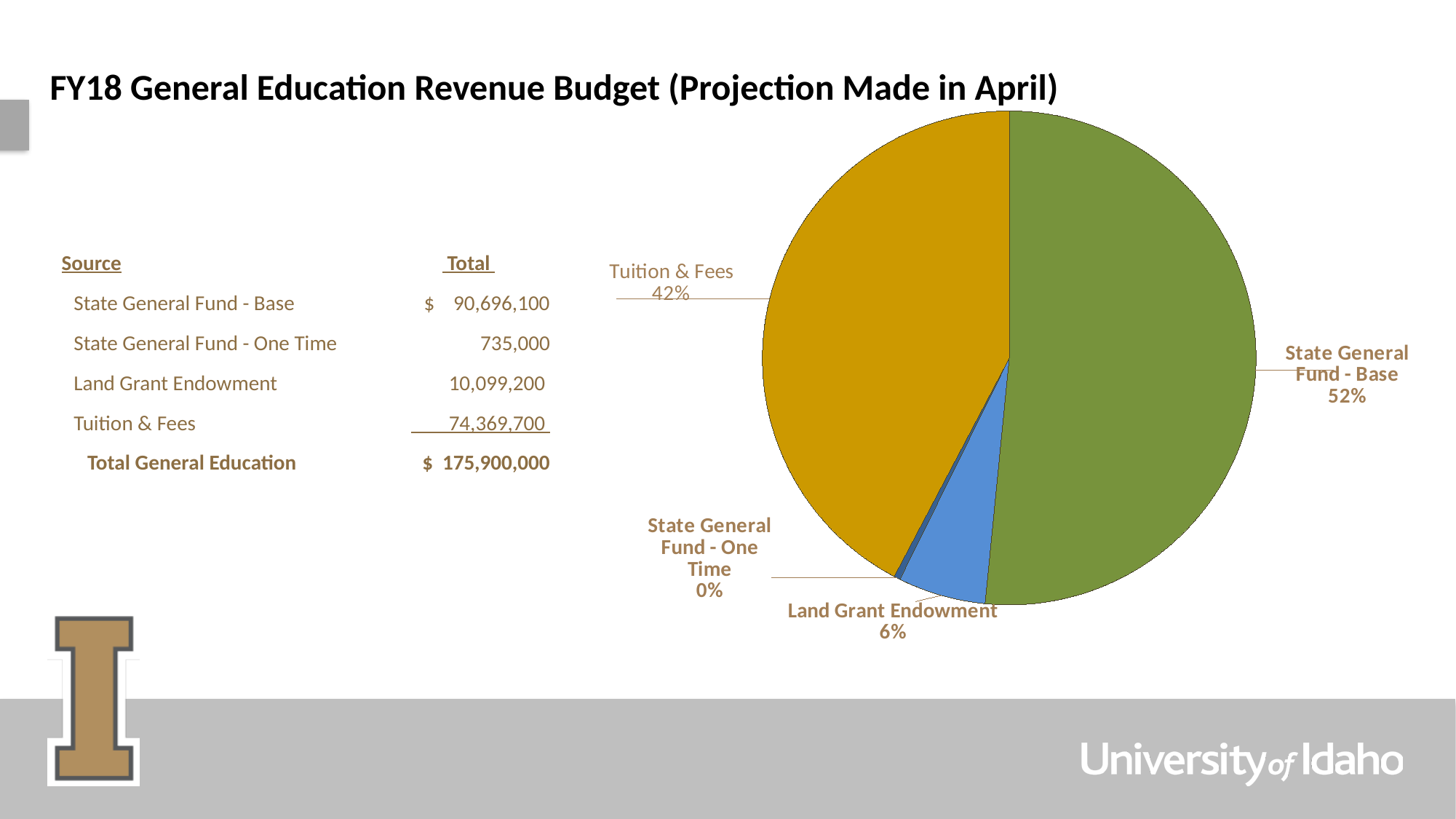
What is the difference in percentage points between the State General Fund - Base slice and the Tuition & Fees slice? 10 percentage points What colour is the Land Grant Endowment slice of the pie chart? blue Which is larger in the pie chart, Tuition & Fees or Land Grant Endowment? Tuition & Fees What share of the pie does State General Fund - Base represent? 52% What percentage is labelled for State General Fund - One Time on the pie chart? 0% What share of the pie does Tuition & Fees represent? 42% Which slice of the pie chart is the smallest? State General Fund - One Time What share of the pie does Land Grant Endowment represent? 6% How many slices does the pie chart have? 4 What colour is the Tuition & Fees slice of the pie chart? gold Which slice of the pie chart is the largest? State General Fund - Base What kind of chart is shown on the slide? pie chart